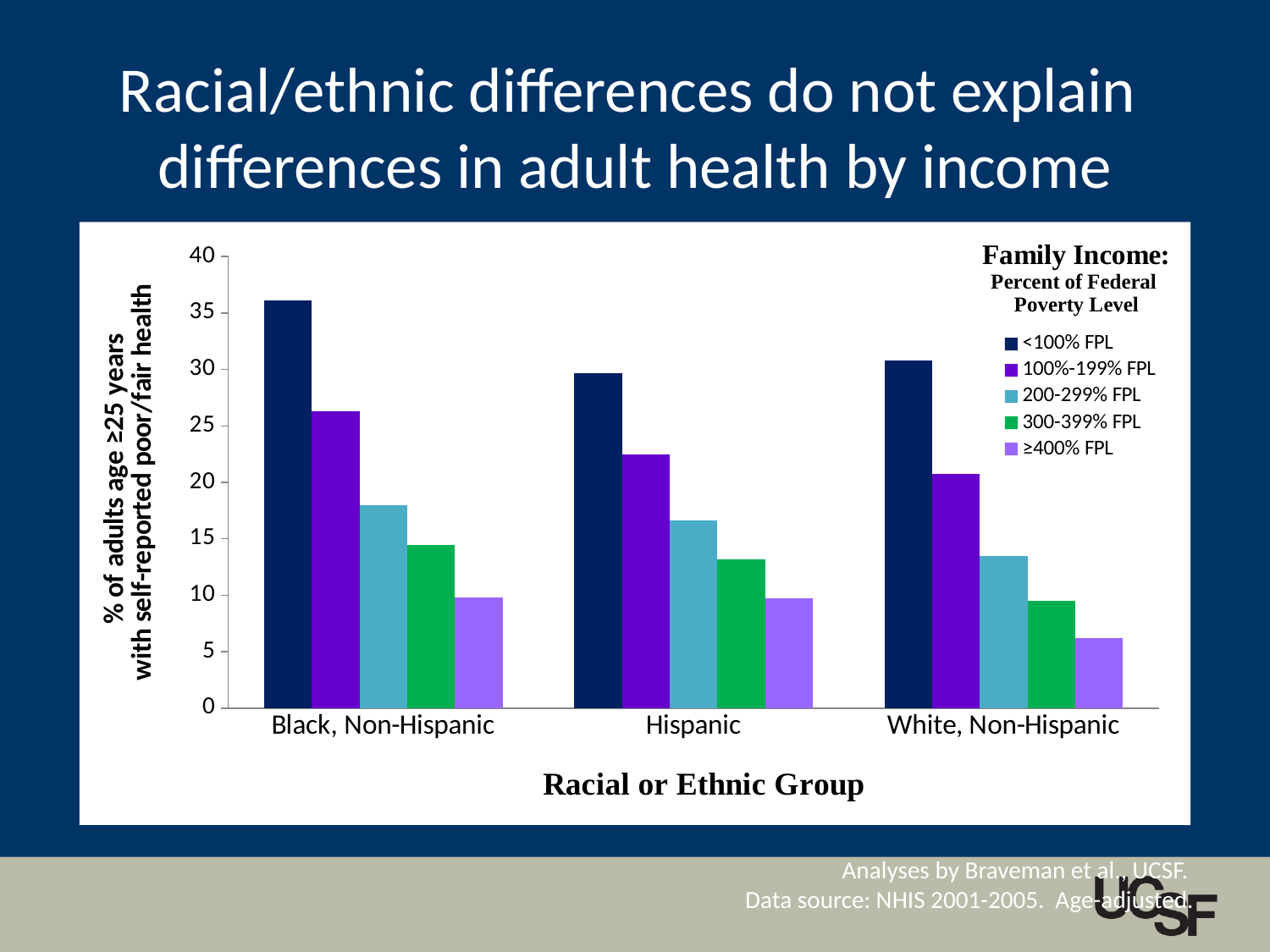
Is the value for White, Non-Hispanic adults with family income ≥400% FPL greater or less than 10? less Which is larger: the <100% FPL bar for Black, Non-Hispanic or the <100% FPL bar for Hispanic? Black, Non-Hispanic How many racial or ethnic groups are shown on the x axis? 3 How many family income series does the legend list? 5 Is the value for Hispanic adults with family income 300-399% FPL greater or less than 15? less Is the value for Black, Non-Hispanic adults with family income <100% FPL greater or less than 30? greater Within each racial or ethnic group, do the bars rise or fall as family income increases from <100% FPL to ≥400% FPL? fall What kind of chart is shown on the slide? Bar chart What is the title of the x axis? Racial or Ethnic Group Which racial or ethnic group and income level has the shortest bar in the chart? White, Non-Hispanic, ≥400% FPL Which racial or ethnic group and income level has the tallest bar in the chart? Black, Non-Hispanic, <100% FPL